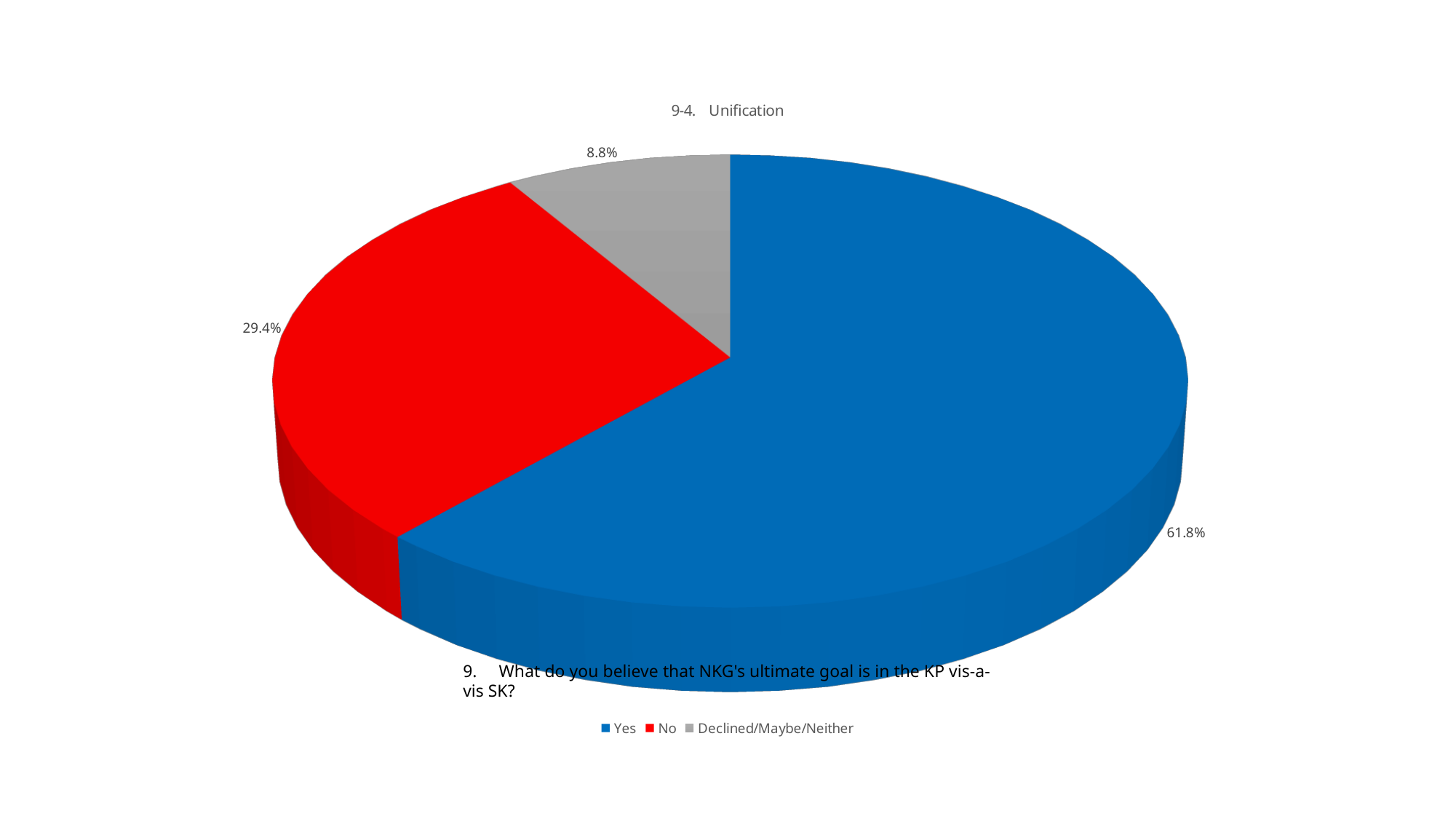
What percentage of the pie is the No slice? 29.4% What is the title of the chart? 9-4. Unification What colour is the No slice? Red Which slice is larger, No or Declined/Maybe/Neither? No What percentage of the pie is the Declined/Maybe/Neither slice? 8.8% How many categories does the legend list? 3 Which category has the largest share of the pie? Yes Which category has the smallest share of the pie? Declined/Maybe/Neither What is the difference in percentage points between the Yes and No slices? 32.4 What percentage of the pie is the Yes slice? 61.8% What type of chart is shown on the slide? Pie chart What is the combined share of the No and Declined/Maybe/Neither slices? 38.2%